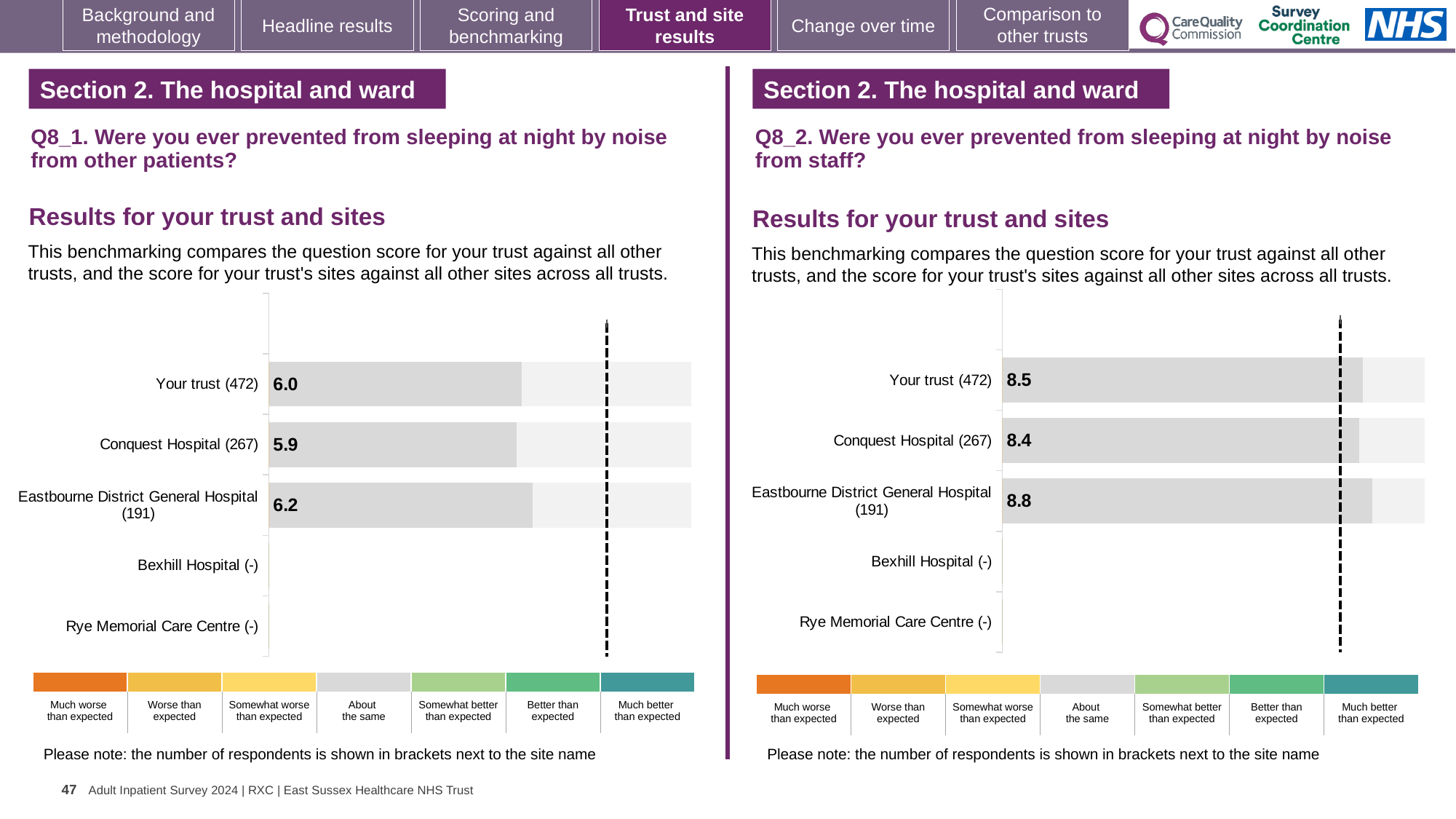
On the Q8_1 chart (noise from other patients), what is the score for Eastbourne District General Hospital (191)? 6.2 On the Q8_1 chart (noise from other patients), what is the score for Conquest Hospital (267)? 5.9 What kind of chart is used for the Q8_2 results (noise from staff)? Bar chart How many benchmark categories does the colour key below the Q8_1 chart show? 7 On the Q8_2 chart (noise from staff), which site has the highest score? Eastbourne District General Hospital (191) On the Q8_2 chart (noise from staff), what is the score for Eastbourne District General Hospital (191)? 8.8 How many categories are listed on the Q8_1 chart (noise from other patients)? 5 On the Q8_1 chart (noise from other patients), which has the larger score: Your trust (472) or Eastbourne District General Hospital (191)? Eastbourne District General Hospital (191) On the Q8_1 chart (noise from other patients), which site has the lowest score? Conquest Hospital (267) On the Q8_2 chart (noise from staff), what is the difference between the scores for Eastbourne District General Hospital (191) and Conquest Hospital (267)? 0.4 On the Q8_2 chart (noise from staff), what is the score for Your trust (472)? 8.5 On the Q8_1 chart (noise from other patients), what is the score for Your trust (472)? 6.0